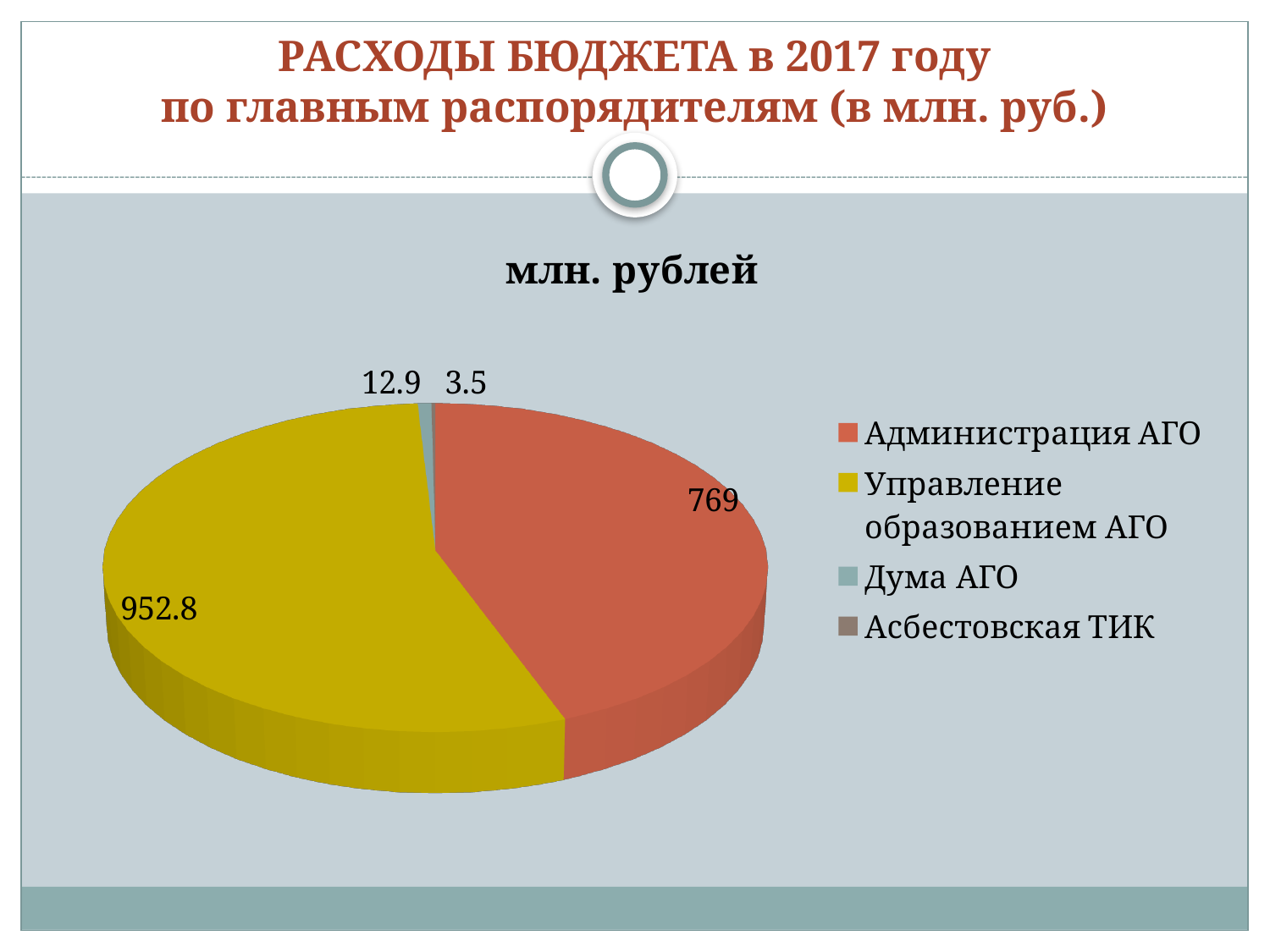
What is the value for Дума АГО? 12.9 What is the title shown above the pie chart? млн. рублей How many categories does the pie chart show? 4 What is the difference between the values for Управление образованием АГО and Администрация АГО? 183.8 Which category has the smallest slice of the pie? Асбестовская ТИК What is the total of all slices in the pie chart? 1738.2 Which is larger, the value for Дума АГО or the value for Асбестовская ТИК? Дума АГО Which category has the largest slice of the pie? Управление образованием АГО What is the value for Асбестовская ТИК? 3.5 What is the value for Администрация АГО? 769 What is the value for Управление образованием АГО? 952.8 What type of chart is shown on the slide? Pie chart